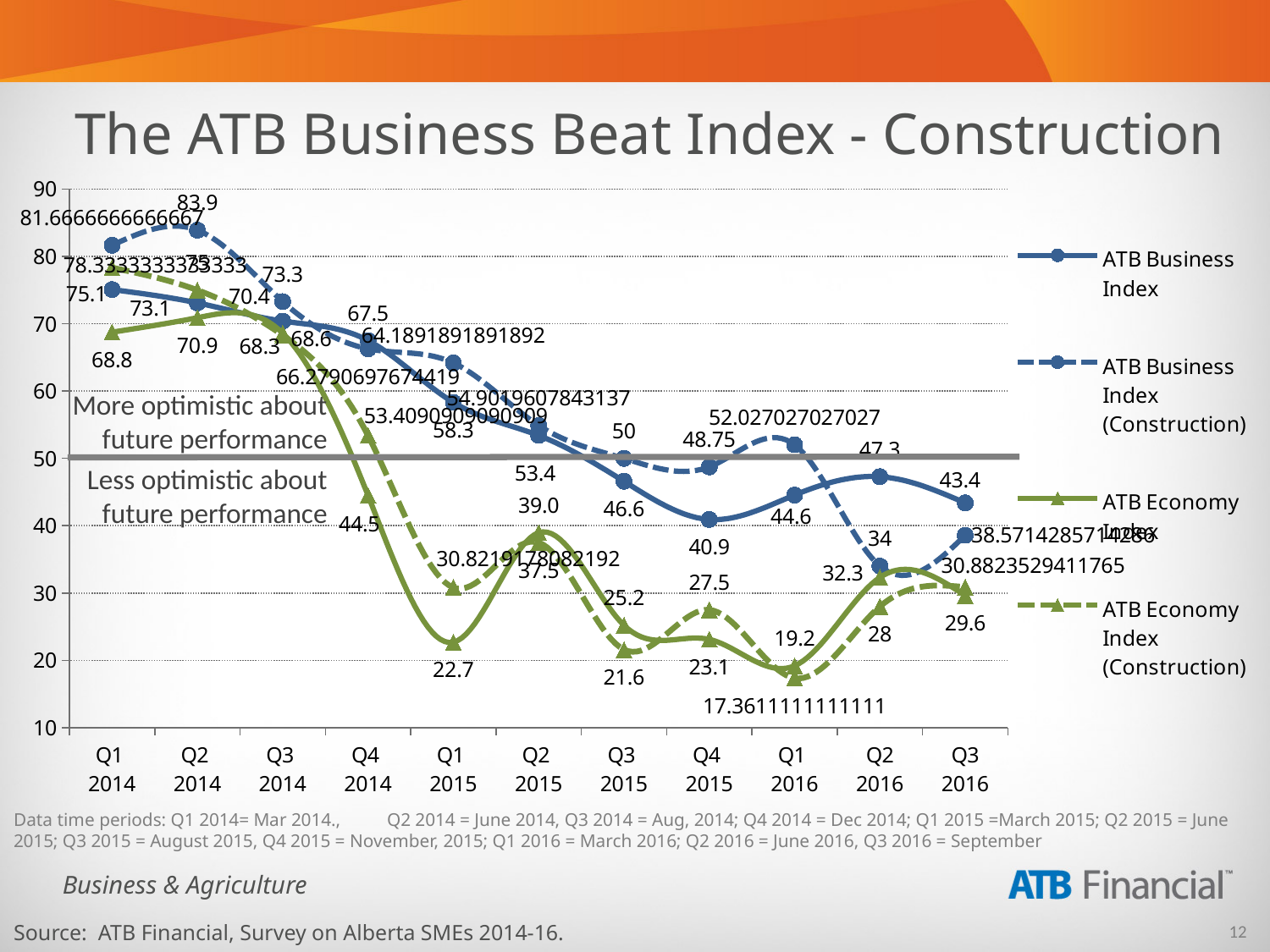
By how much did the ATB Business Index fall from Q1 2014 to Q3 2016? 31.7 In which quarter is the ATB Economy Index at its lowest? Q1 2016 Does the ATB Business Index rise or fall from Q1 2014 to Q4 2015? Fall How many series does the legend list? 4 How many quarters are plotted along the x axis? 11 At what value is the horizontal line that separates 'More optimistic' from 'Less optimistic about future performance'? 50 What is the value of the ATB Business Index (Construction) in Q3 2015? 50 What is the value of the ATB Business Index in Q4 2015? 40.9 In Q2 2016, which is larger: the ATB Business Index or the ATB Business Index (Construction)? ATB Business Index In which quarter does the ATB Business Index (Construction) reach its highest value? Q2 2014 What kind of chart is shown on the slide? Line chart What is the value of the ATB Economy Index in Q1 2015? 22.7